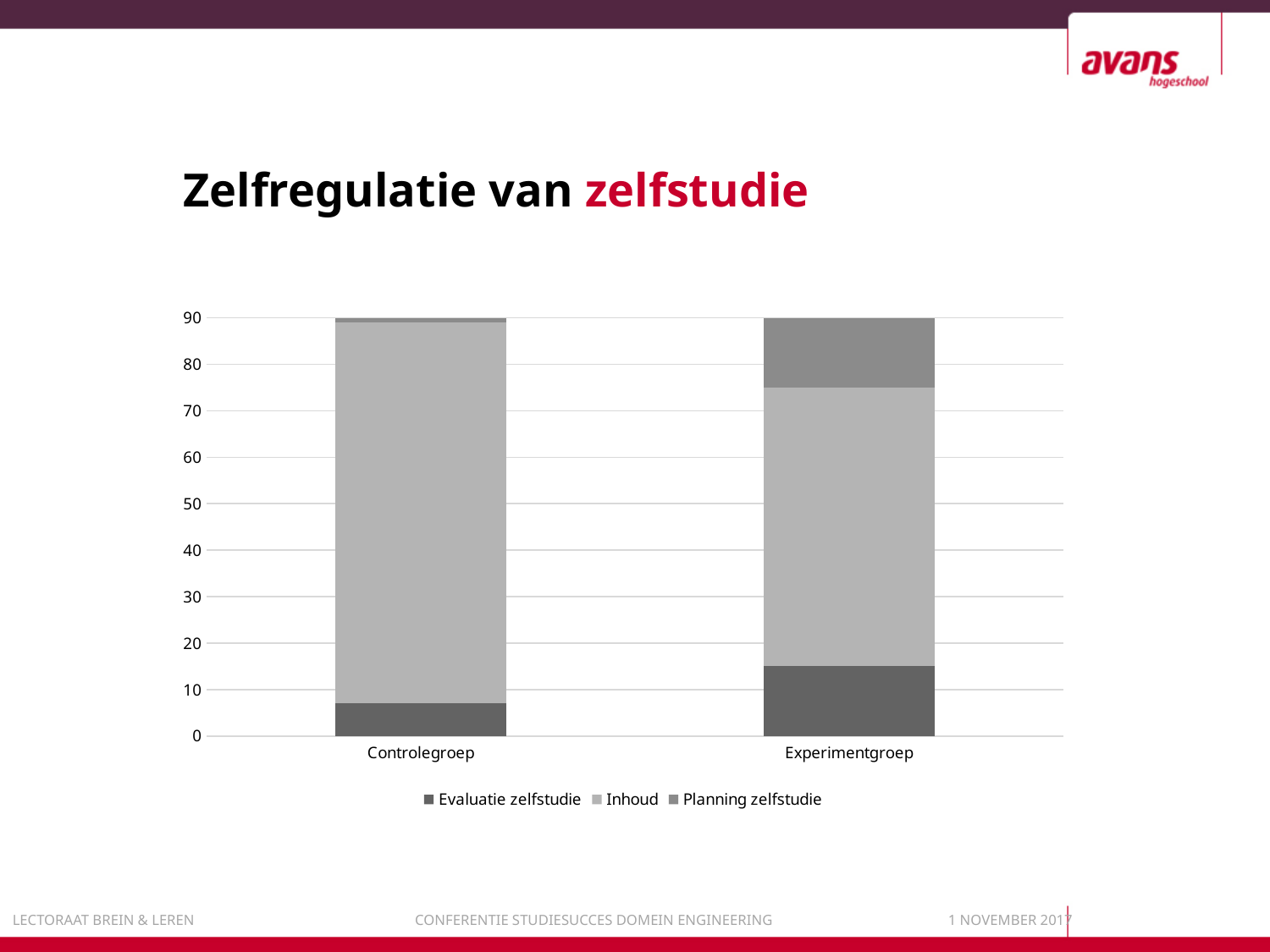
Is the value of Evaluatie zelfstudie for Experimentgroep greater or less than 10? greater Which group has the larger Inhoud segment, Controlegroep or Experimentgroep? Controlegroep Which group has the larger Planning zelfstudie segment, Controlegroep or Experimentgroep? Experimentgroep What is the total height of the stacked bar for Experimentgroep? 90 Which group has the larger Evaluatie zelfstudie segment, Controlegroep or Experimentgroep? Experimentgroep Is the value of Evaluatie zelfstudie for Controlegroep greater or less than 10? less Which series are listed in the chart legend? Evaluatie zelfstudie, Inhoud, Planning zelfstudie What is the total height of the stacked bar for Controlegroep? 90 How many categories are shown on the x axis of the chart? 2 How many series does the chart legend list? 3 Is the value of Inhoud for Controlegroep greater or less than 70? greater What kind of chart is shown on the slide? Stacked bar chart